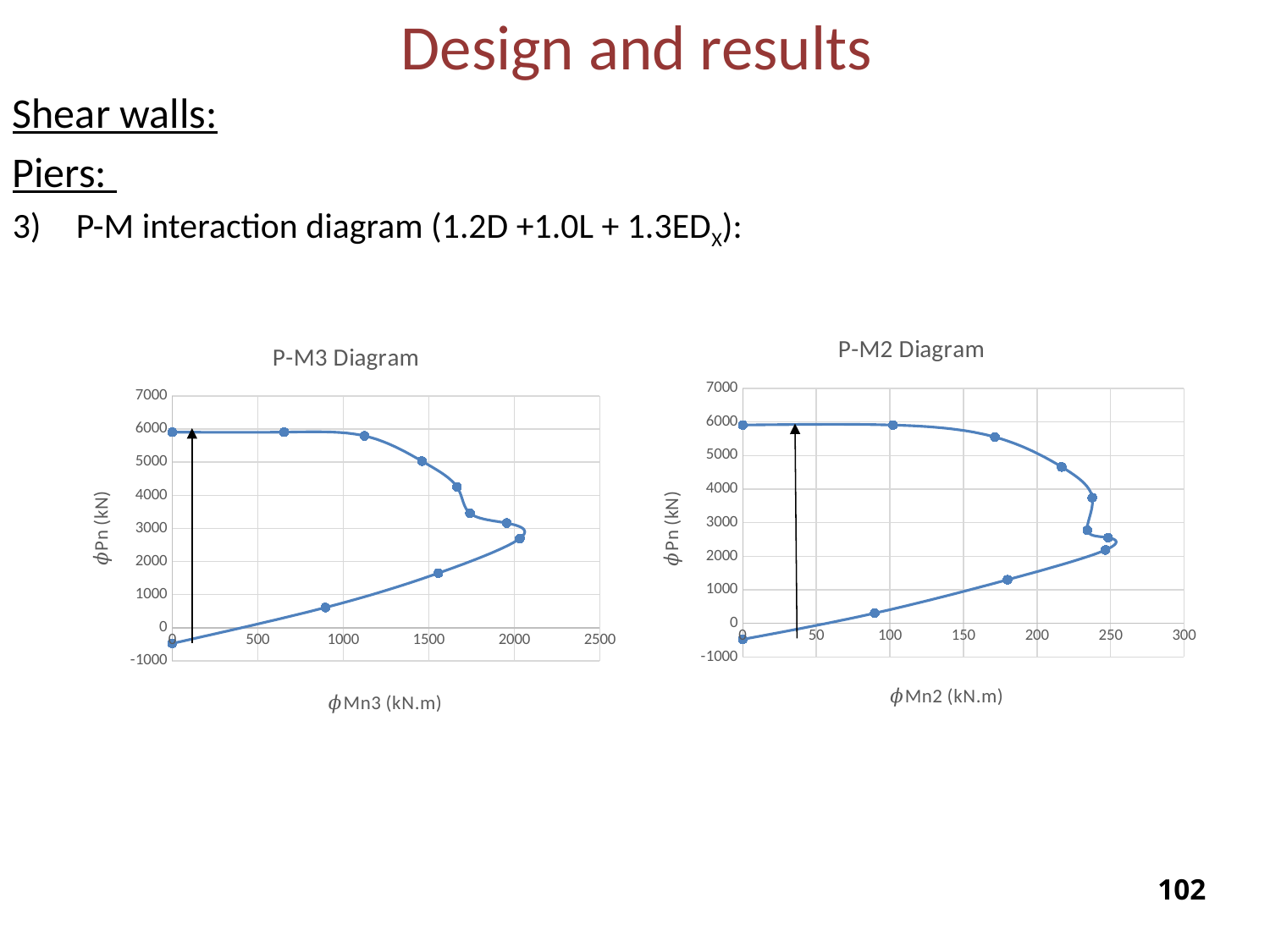
In the P-M3 Diagram, is the maximum ϕMn3 value greater or less than 2500? less In the P-M3 Diagram, is the lowest ϕPn value greater or less than 0? less What kind of chart is the P-M3 Diagram? Scatter chart with lines In the P-M2 Diagram, is the maximum ϕMn2 value greater or less than 300? less What is the title of the chart on the right side of the slide? P-M2 Diagram In the P-M3 Diagram, what is the label of the horizontal axis? ϕMn3 (kN.m)